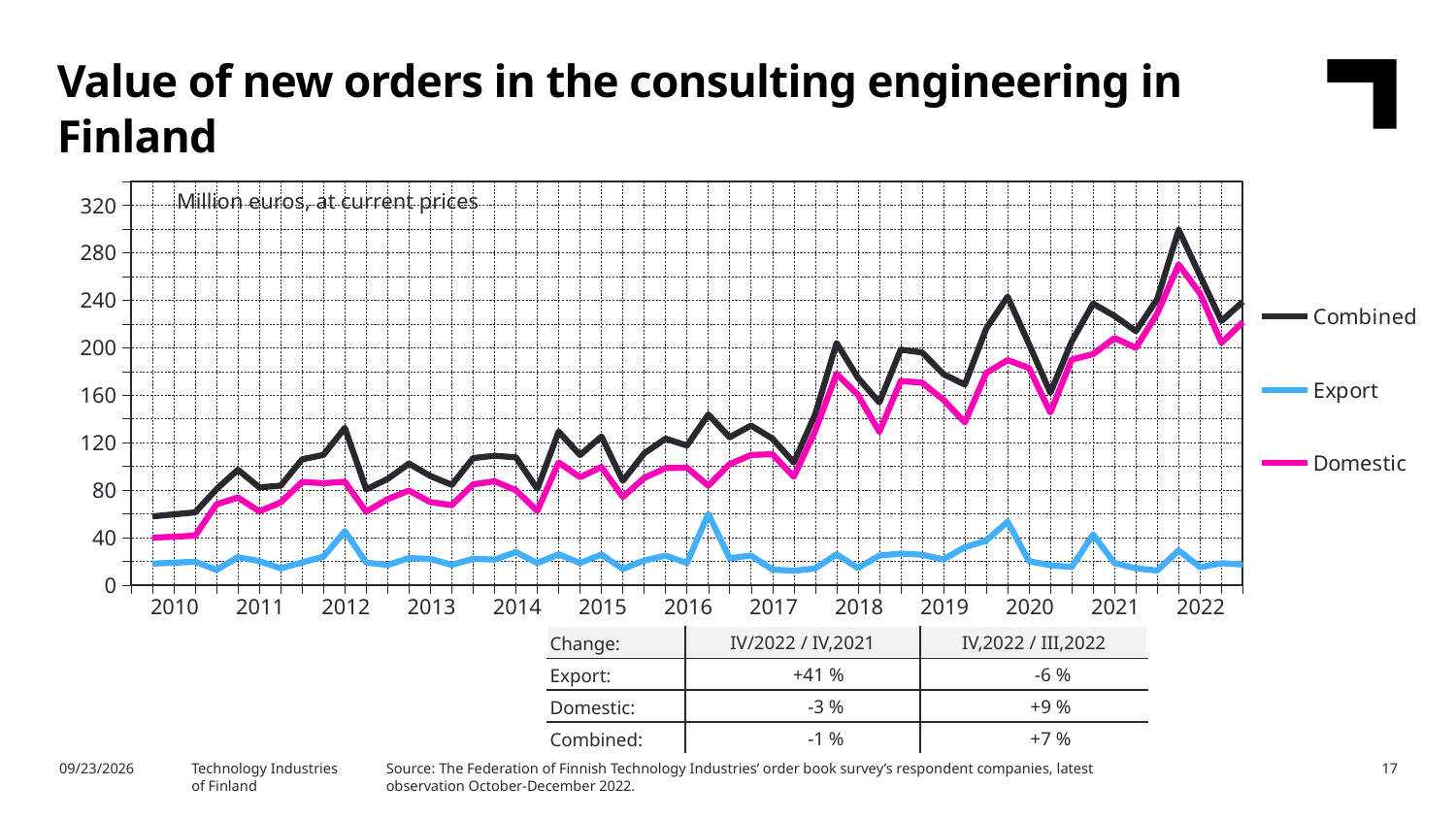
What kind of chart is shown on the slide? line chart Which series has the lowest values throughout the chart? Export Is the highest value of the Export series (in 2016) greater or less than 40? greater Is the peak value of the Combined series in late 2021 greater or less than 280? greater What are the three series named in the legend? Combined, Export, Domestic Which series has the highest values throughout the chart? Combined How many series does the legend list? 3 Overall, does the Combined series rise or fall from 2010 to 2022? rise According to the table below the chart, what is the Export change for IV/2022 / IV,2021? +41 % Is the value of the Combined series at the start of 2010 greater or less than 80? less Which is larger in 2022, the Domestic series or the Export series? Domestic What unit is stated in the chart's subtitle? Million euros, at current prices